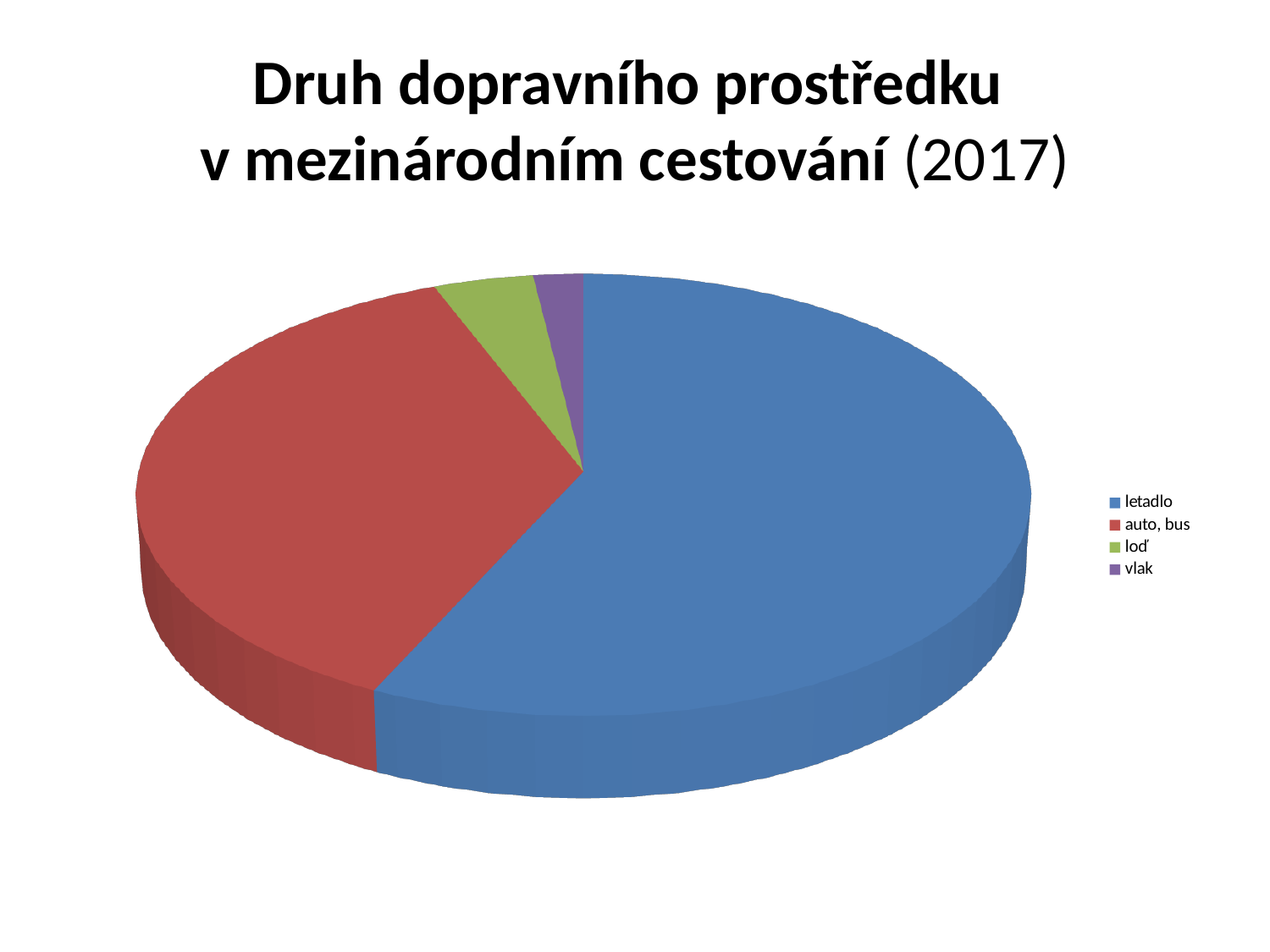
How many entries does the legend list? 4 Which category has the smallest slice of the pie? vlak What kind of chart is shown on the slide? pie chart How many categories does the pie chart show? 4 What colour is the slice for letadlo? blue Which category has the second largest slice of the pie? auto, bus Which category has the largest slice of the pie? letadlo Which slice is larger, letadlo or auto, bus? letadlo What is the title of the chart? Druh dopravního prostředku v mezinárodním cestování (2017) Which slice is larger, loď or vlak? loď Which slice is larger, auto, bus or loď? auto, bus